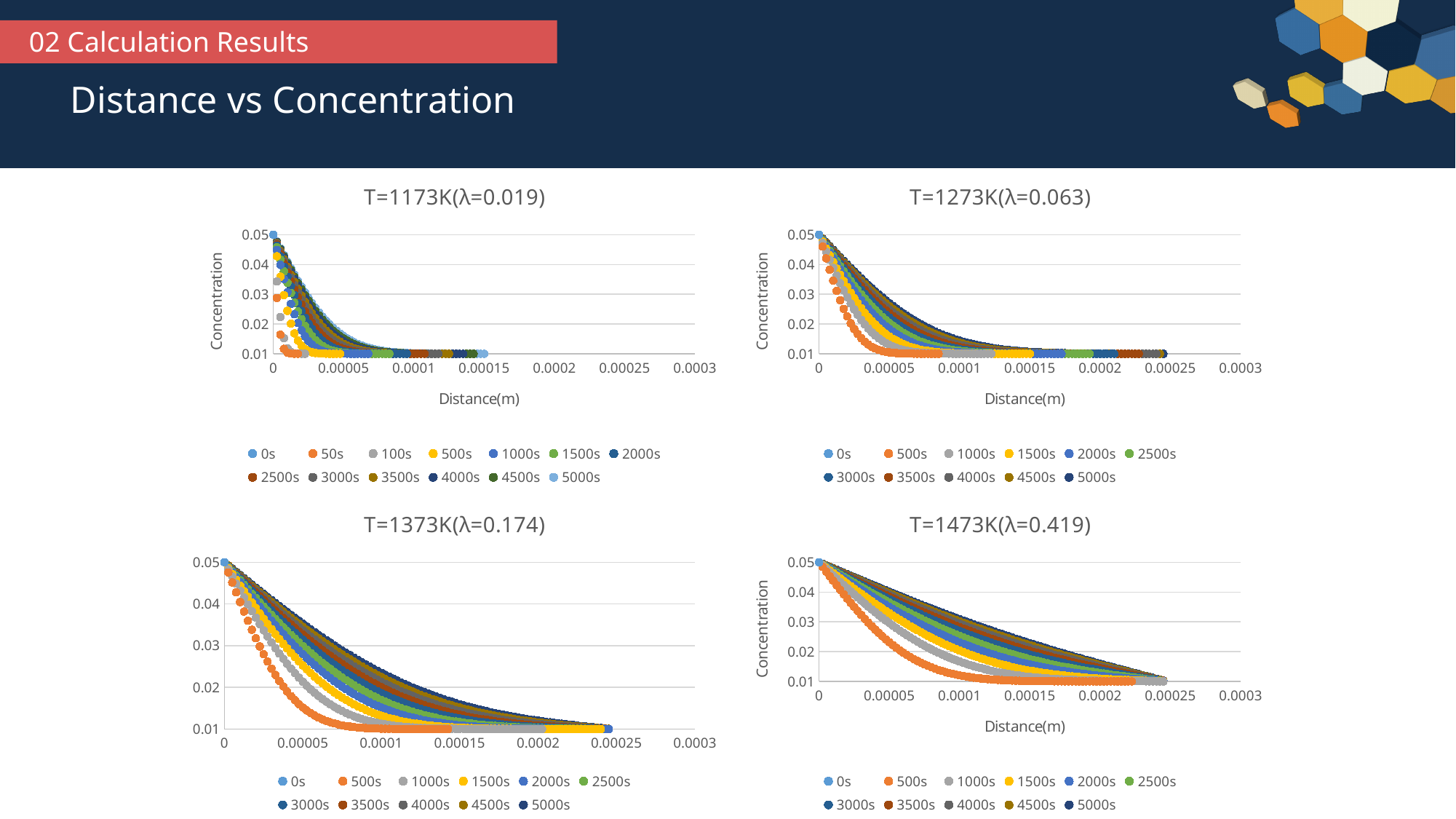
In the T=1373K(λ=0.174) chart, does concentration rise or fall as distance increases? Fall In the T=1473K(λ=0.419) chart, what is the concentration at distance 0 for the 0s series? 0.05 How many series does the legend of the T=1173K(λ=0.019) chart list? 13 What is the x-axis title of the T=1273K(λ=0.063) chart? Distance(m) What is the y-axis title of the T=1173K(λ=0.019) chart? Concentration In the T=1373K(λ=0.174) chart, is the concentration of the 5000s series at distance 0.0001 greater or less than 0.02? greater In the T=1173K(λ=0.019) chart, is the concentration of the 5000s series at distance 0.0001 greater or less than 0.02? less In the T=1473K(λ=0.419) chart, is the concentration of the 500s series at distance 0.0001 greater or less than 0.02? less What kind of chart is the T=1173K(λ=0.019) chart? Scatter chart How many series does the legend of the T=1273K(λ=0.063) chart list? 11 How many series does the legend of the T=1473K(λ=0.419) chart list? 11